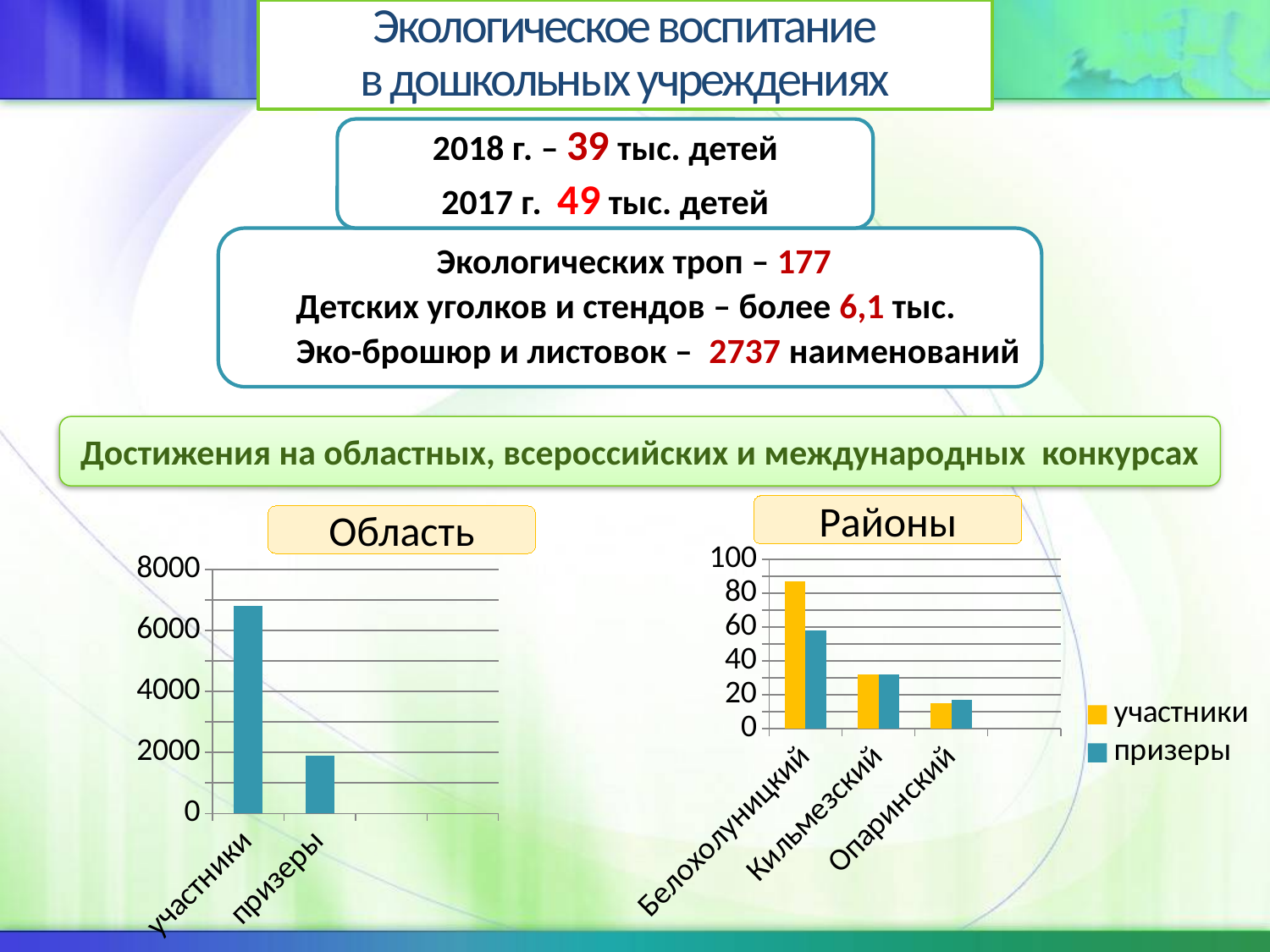
In the "Область" chart, is the value for участники greater or less than 6000? greater How many districts are shown on the x axis of the "Районы" chart? 3 In the "Районы" chart, which district has the lowest value for призеры? Опаринский In the "Область" chart, is the value for призеры greater or less than 2000? less How many categories are shown on the x axis of the "Область" chart? 2 What kind of chart is the "Область" chart on the left? bar chart In the "Область" chart, which category has the higher bar, участники or призеры? участники In the "Районы" chart, is the value for призеры in Кильмезский greater or less than 40? less In the "Районы" chart, which district has the highest value for участники? Белохолуницкий In the "Районы" chart, which colour represents the участники series? yellow How many series does the legend of the "Районы" chart list? 2